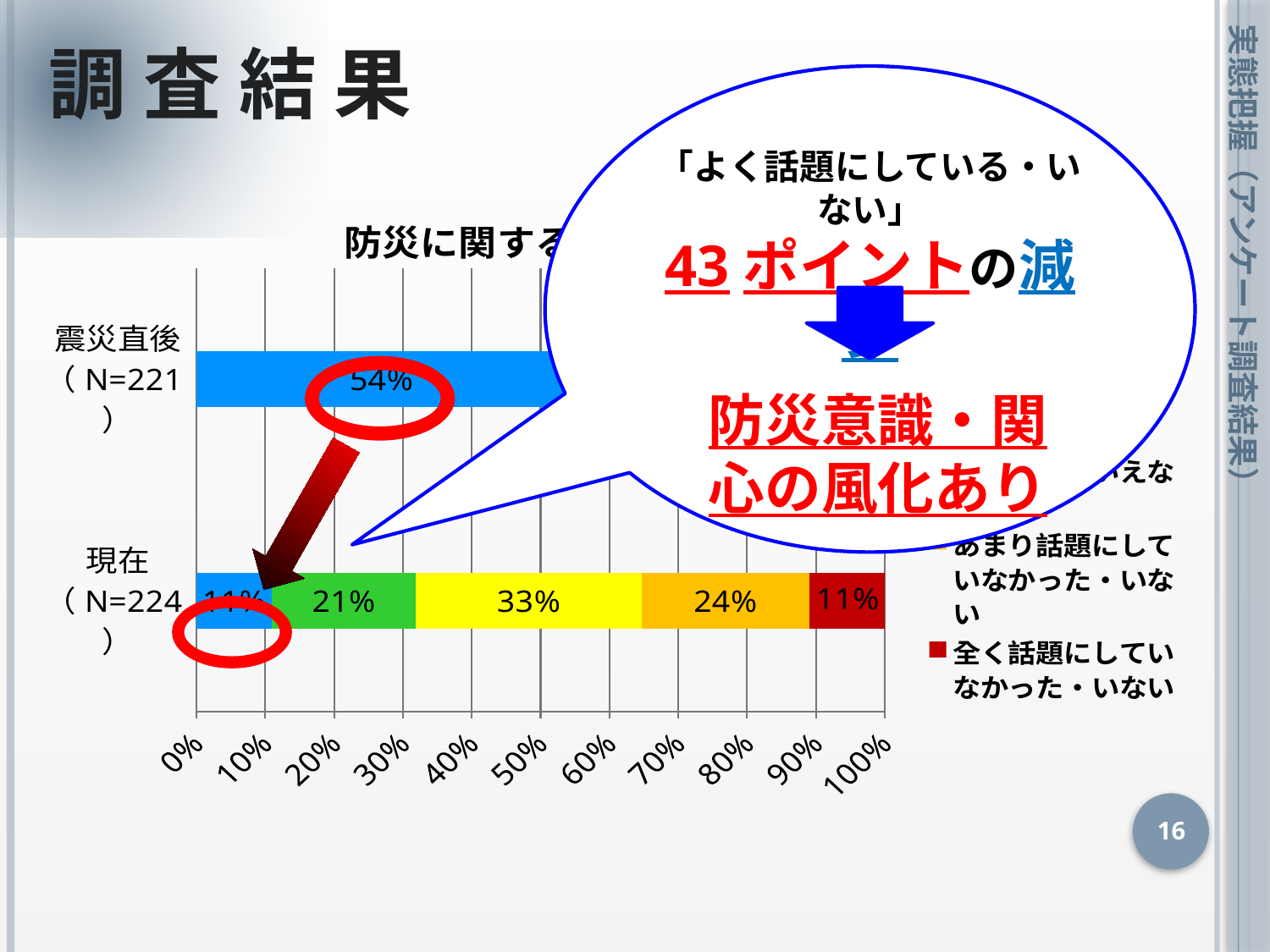
By how many percentage points does the blue segment for 震災直後 exceed the blue segment for 現在? 43 What is the value of the 「全く話題にしていなかった・いない」 (dark red) segment for 現在 (N=224)? 11% What is the value of the yellow segment for 現在 (N=224)? 33% What is the value of the blue segment for 震災直後 (N=221)? 54% What is the value of the green segment for 現在 (N=224)? 21% Is the blue segment for 震災直後 greater or less than 50%? greater What kind of chart is shown on the slide? bar chart What is the value of the blue segment for 現在 (N=224)? 11% Which segment is the largest in the 現在 (N=224) bar? the yellow segment (33%) How many categories (bars) does the chart show? 2 Which is larger: the blue segment for 震災直後 or the blue segment for 現在? 震災直後 What is the value of the 「あまり話題にしていなかった・いない」 (orange) segment for 現在 (N=224)? 24%